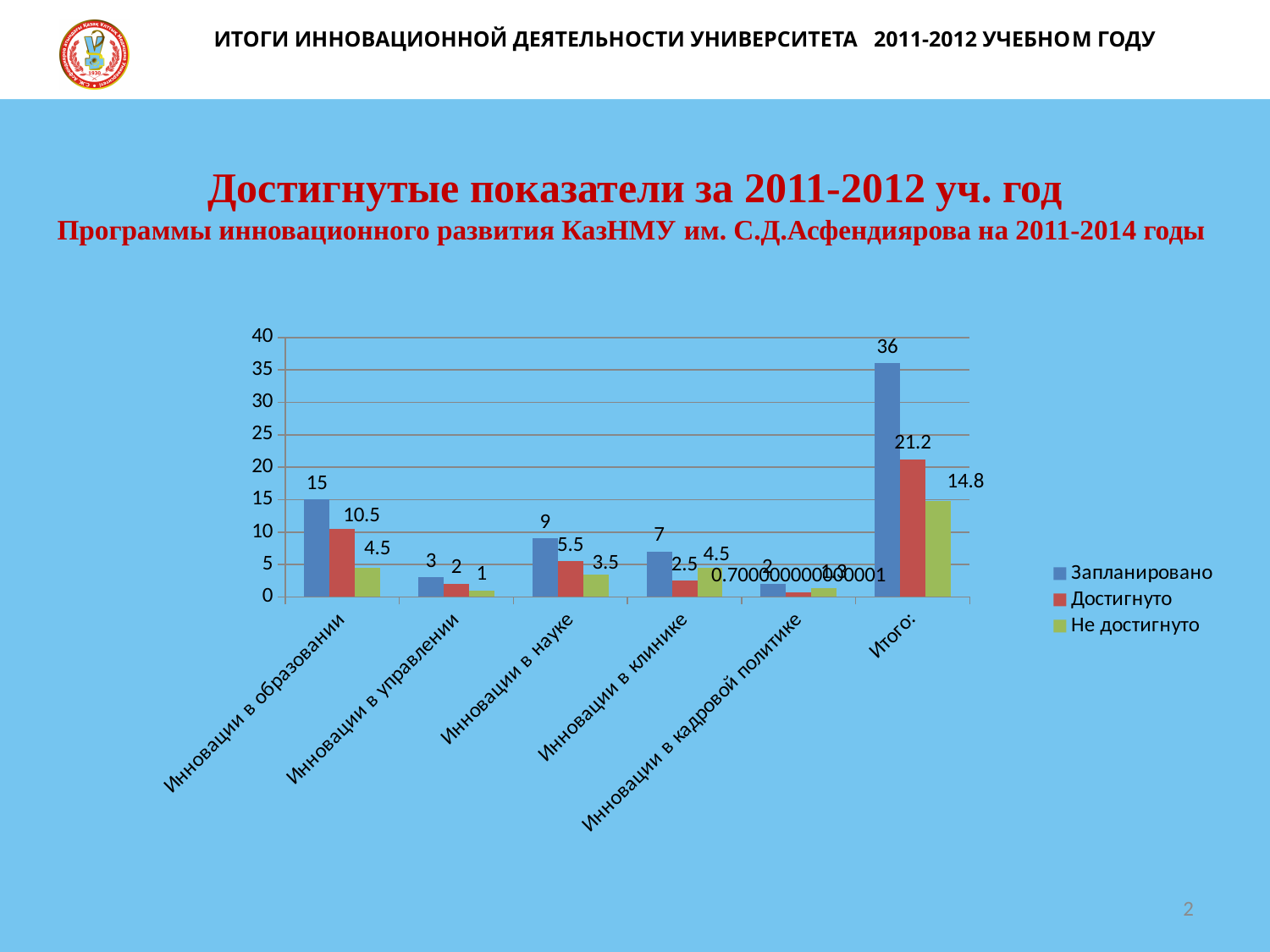
How many series does the legend list? 3 Which legend entry is shown in red? Достигнуто Which category has the lowest Достигнуто value? Инновации в кадровой политике What is the value of Запланировано for Инновации в образовании? 15 What is the value of Не достигнуто for Итого:? 14.8 What is the value of Достигнуто for Инновации в науке? 5.5 Which is larger for Инновации в клинике: Достигнуто or Не достигнуто? Не достигнуто Which category has the highest Запланировано value? Итого: What is the difference between Запланировано and Достигнуто for Итого:? 14.8 How many categories are shown on the x axis? 6 What type of chart is shown on the slide? bar chart Is the Запланировано value for Инновации в кадровой политике greater or less than 5? less